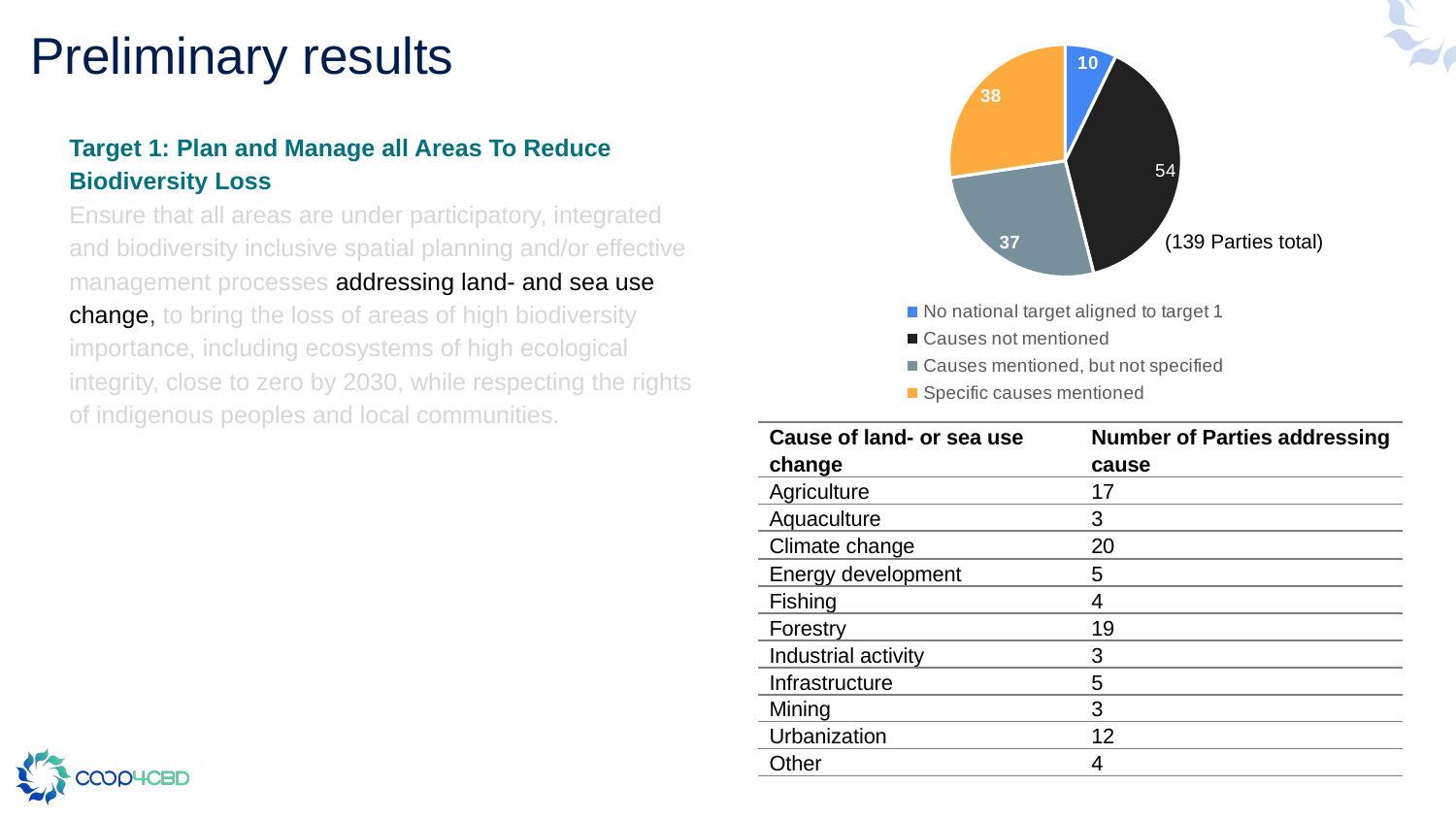
In the pie chart, how many Parties fall under "Causes not mentioned"? 54 In the pie chart, which is larger: "Specific causes mentioned" or "Causes mentioned, but not specified"? Specific causes mentioned What type of chart is shown on the slide? Pie chart In the pie chart, what is the value for "Causes mentioned, but not specified"? 37 Which category has the smallest slice in the pie chart? No national target aligned to target 1 In the pie chart, how much larger is "Specific causes mentioned" than "No national target aligned to target 1"? 28 In the pie chart, what is the value for "No national target aligned to target 1"? 10 Which category has the largest slice in the pie chart? Causes not mentioned According to the label next to the pie chart, how many Parties in total does the chart represent? 139 Parties total In the pie chart, what is the difference between "Causes not mentioned" and "Causes mentioned, but not specified"? 17 How many slices does the pie chart have? 4 In the pie chart, what is the value for "Specific causes mentioned"? 38